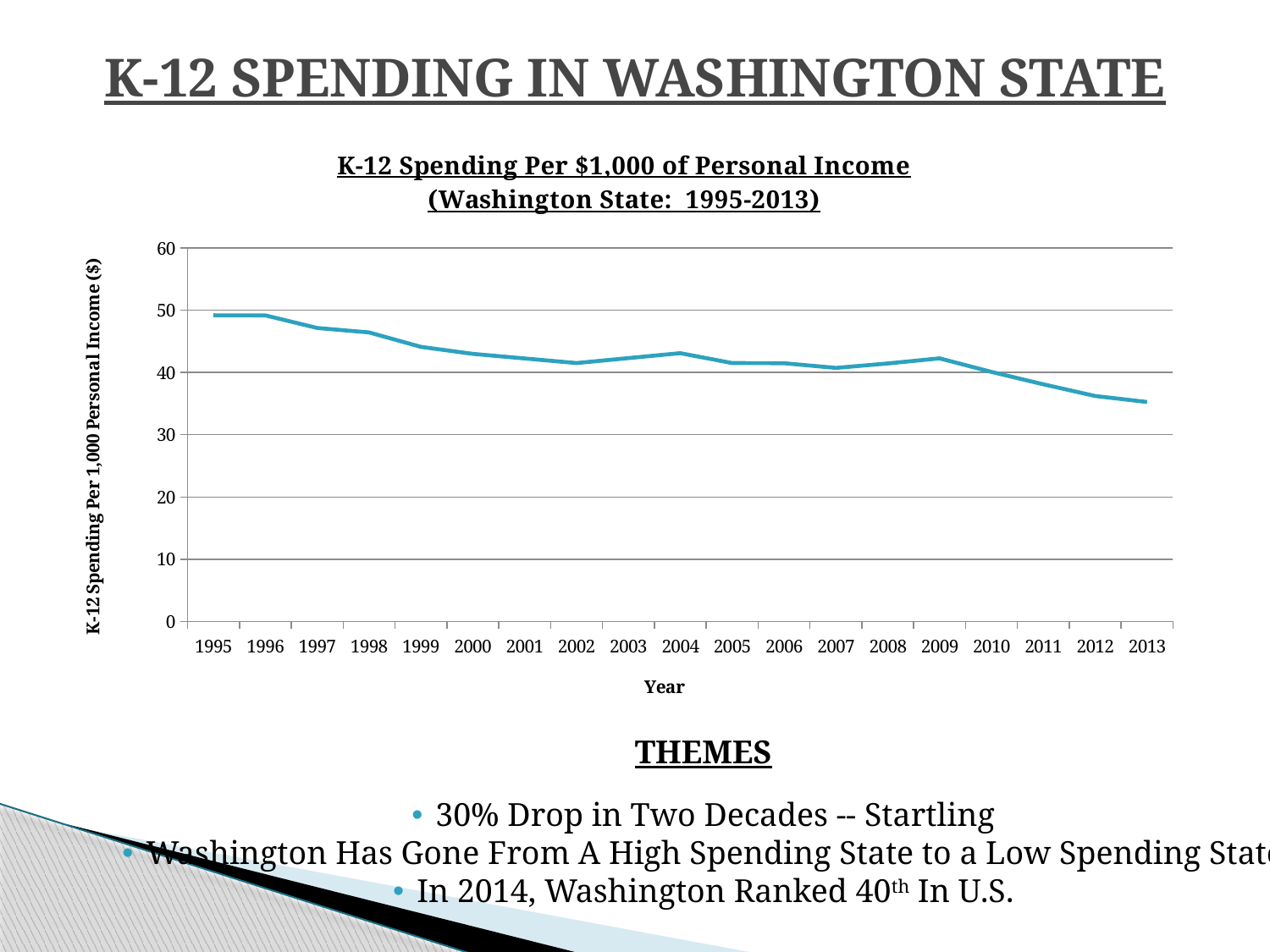
Is the value for 1995 greater or less than 40? greater Is the value for 2011 greater or less than 40? less What is the label of the x axis? Year How many years are plotted on the x axis? 19 What is the title of the chart? K-12 Spending Per $1,000 of Personal Income (Washington State: 1995-2013) Is the value for 2013 greater or less than 30? greater Overall, do the values rise or fall from 1995 to 2013? fall Which year has the lowest K-12 spending per $1,000 of personal income? 2013 What kind of chart is shown on the slide? line chart Which year has the larger value, 1995 or 2013? 1995 Which year has the larger value, 1997 or 2012? 1997